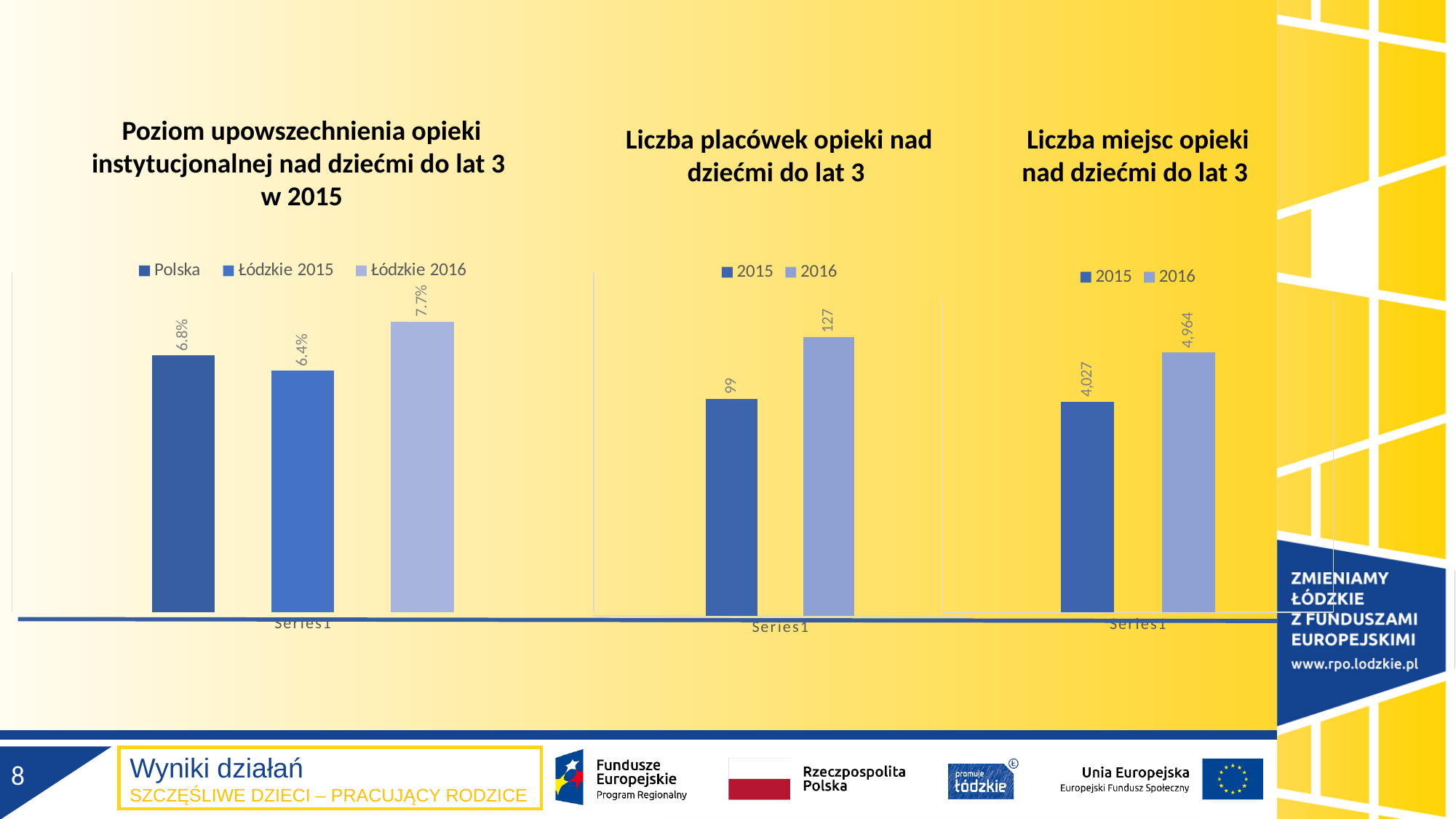
In the chart 'Poziom upowszechnienia opieki instytucjonalnej nad dziećmi do lat 3 w 2015', what is the value for Polska? 6.8% In the chart 'Poziom upowszechnienia opieki instytucjonalnej nad dziećmi do lat 3 w 2015', what is the difference between Łódzkie 2016 and Łódzkie 2015? 1.3% In the chart 'Poziom upowszechnienia opieki instytucjonalnej nad dziećmi do lat 3 w 2015', how many series does the legend list? 3 What kind of chart is 'Liczba placówek opieki nad dziećmi do lat 3'? Bar chart In the chart 'Liczba placówek opieki nad dziećmi do lat 3', what is the value for 2015? 99 In the chart 'Liczba placówek opieki nad dziećmi do lat 3', what is the difference between 2016 and 2015? 28 In the chart 'Liczba miejsc opieki nad dziećmi do lat 3', what is the value for 2015? 4,027 In the chart 'Liczba miejsc opieki nad dziećmi do lat 3', which year has the higher value, 2015 or 2016? 2016 In the chart 'Liczba miejsc opieki nad dziećmi do lat 3', what is the value for 2016? 4,964 In the chart 'Poziom upowszechnienia opieki instytucjonalnej nad dziećmi do lat 3 w 2015', what is the value for Łódzkie 2016? 7.7% In the chart 'Poziom upowszechnienia opieki instytucjonalnej nad dziećmi do lat 3 w 2015', which series has the lowest value? Łódzkie 2015 In the chart 'Liczba placówek opieki nad dziećmi do lat 3', what is the value for 2016? 127